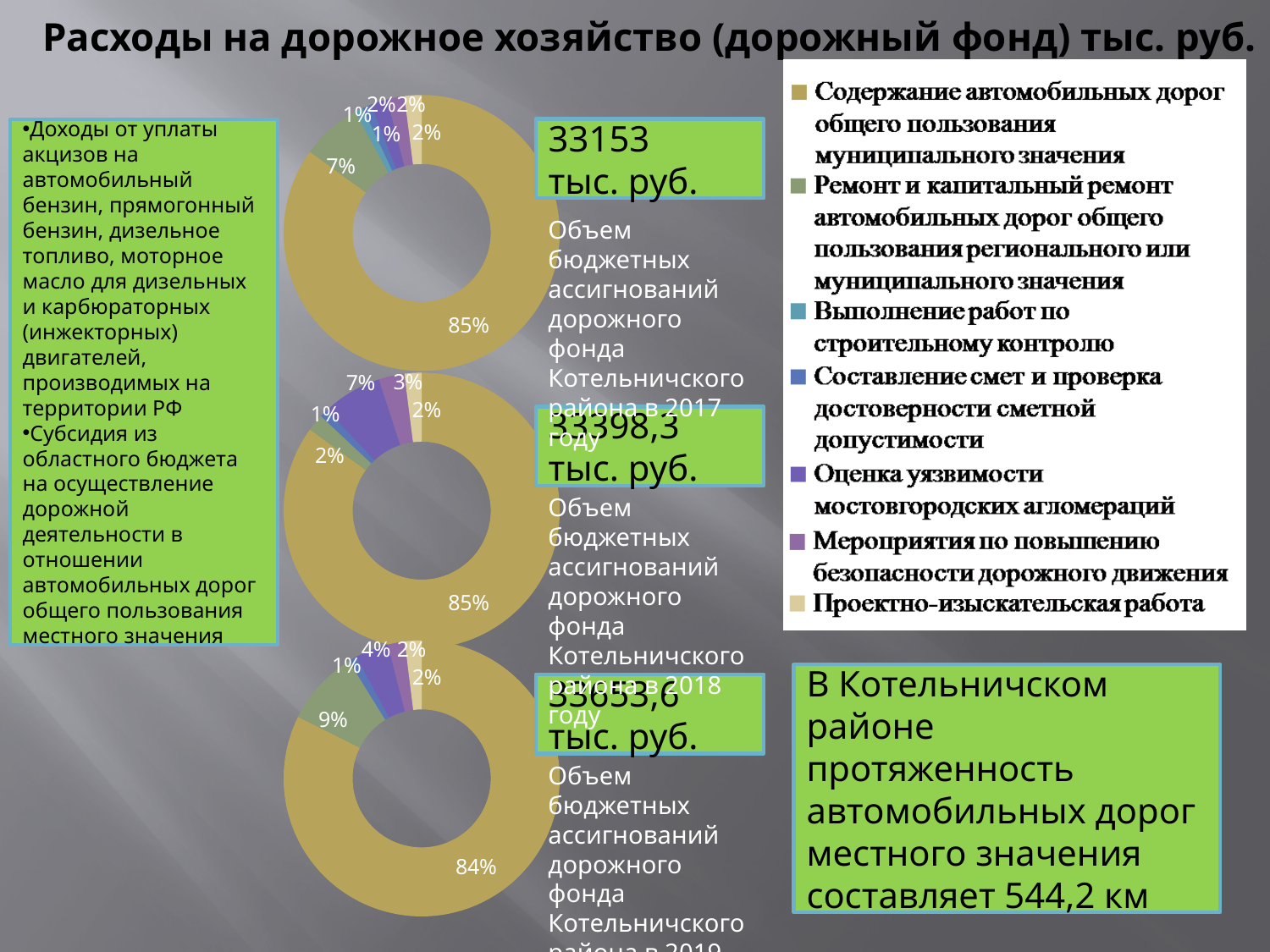
Is the largest slice in the bottom chart (2019) larger or smaller than the largest slice in the top chart (2017)? smaller In the top chart (2017), what share does the green slice (Ремонт и капитальный ремонт автомобильных дорог) have? 7% In the middle chart (2018), what share does the largest slice have? 85% How many charts are on the slide? 3 In the top chart (2017), what share does the largest slice have? 85% What is the title of the slide containing the charts? Расходы на дорожное хозяйство (дорожный фонд) тыс. руб. What type of charts are shown on the slide? Doughnut (pie) charts Which legend category corresponds to the largest slice in all three charts? Содержание автомобильных дорог общего пользования муниципального значения How many entries does the legend list? 7 What is the difference between the largest slice of the top chart (85%) and the largest slice of the bottom chart (84%)? 1%